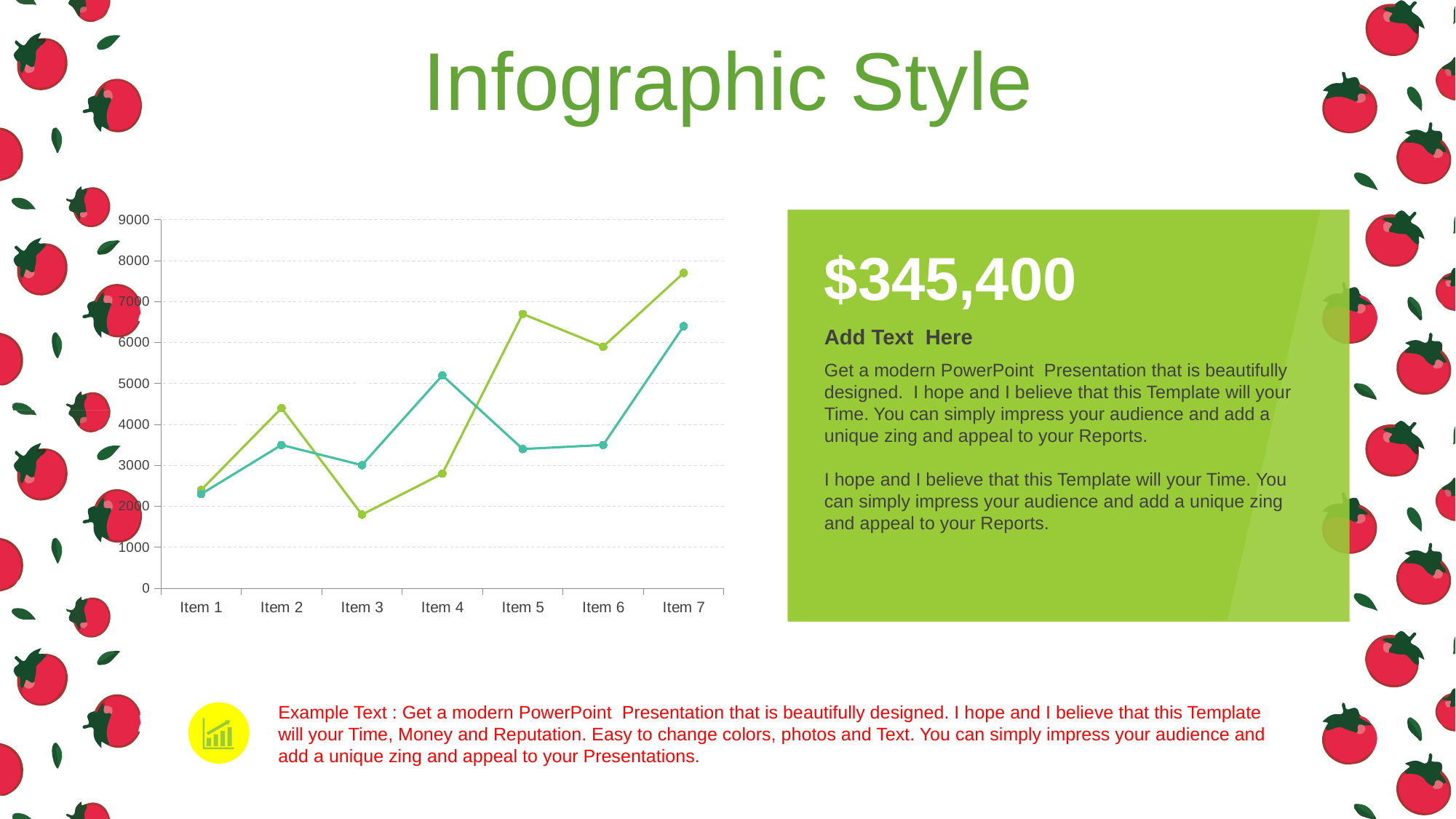
How many lines are plotted on the chart? 2 Is the value of the light green line at Item 3 greater or less than 2000? less At Item 2, which line has the higher value, the light green line or the teal line? the light green line For the light green line, which item has the highest value? Item 7 At Item 4, which line has the higher value, the light green line or the teal line? the teal line Is the value of the light green line at Item 5 greater or less than 6000? greater Is the value of the teal line at Item 4 greater or less than 4000? greater How many categories are shown on the x axis of the chart? 7 For the light green line, which item has the lowest value? Item 3 For the teal line, which item has the highest value? Item 7 What kind of chart is shown on the slide? line chart For the teal line, which item has the lowest value? Item 1